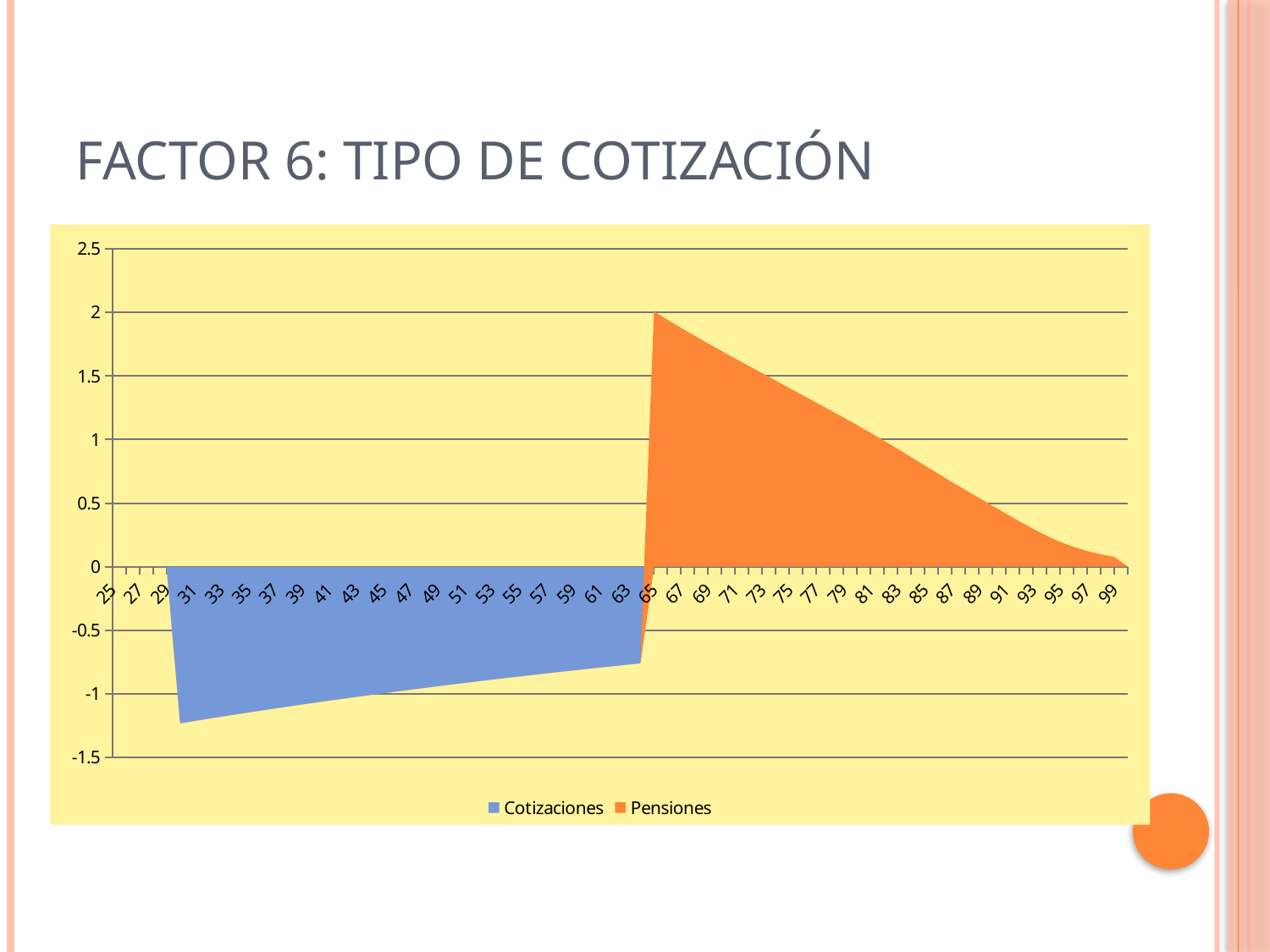
Is the value for Pensiones at 95 greater or less than 0.5? less Which series is drawn in orange? Pensiones Is the value for Pensiones at 65 greater or less than 1.5? greater How many series does the legend list? 2 Which series has positive values, Cotizaciones or Pensiones? Pensiones Do the Pensiones values rise or fall as age increases from 65 to 99? fall What are the two series named in the legend? Cotizaciones and Pensiones Is the value for Cotizaciones at 31 greater or less than -1? less What kind of chart is shown on the slide? area chart At which x-axis value does the Pensiones series reach its highest point? 65